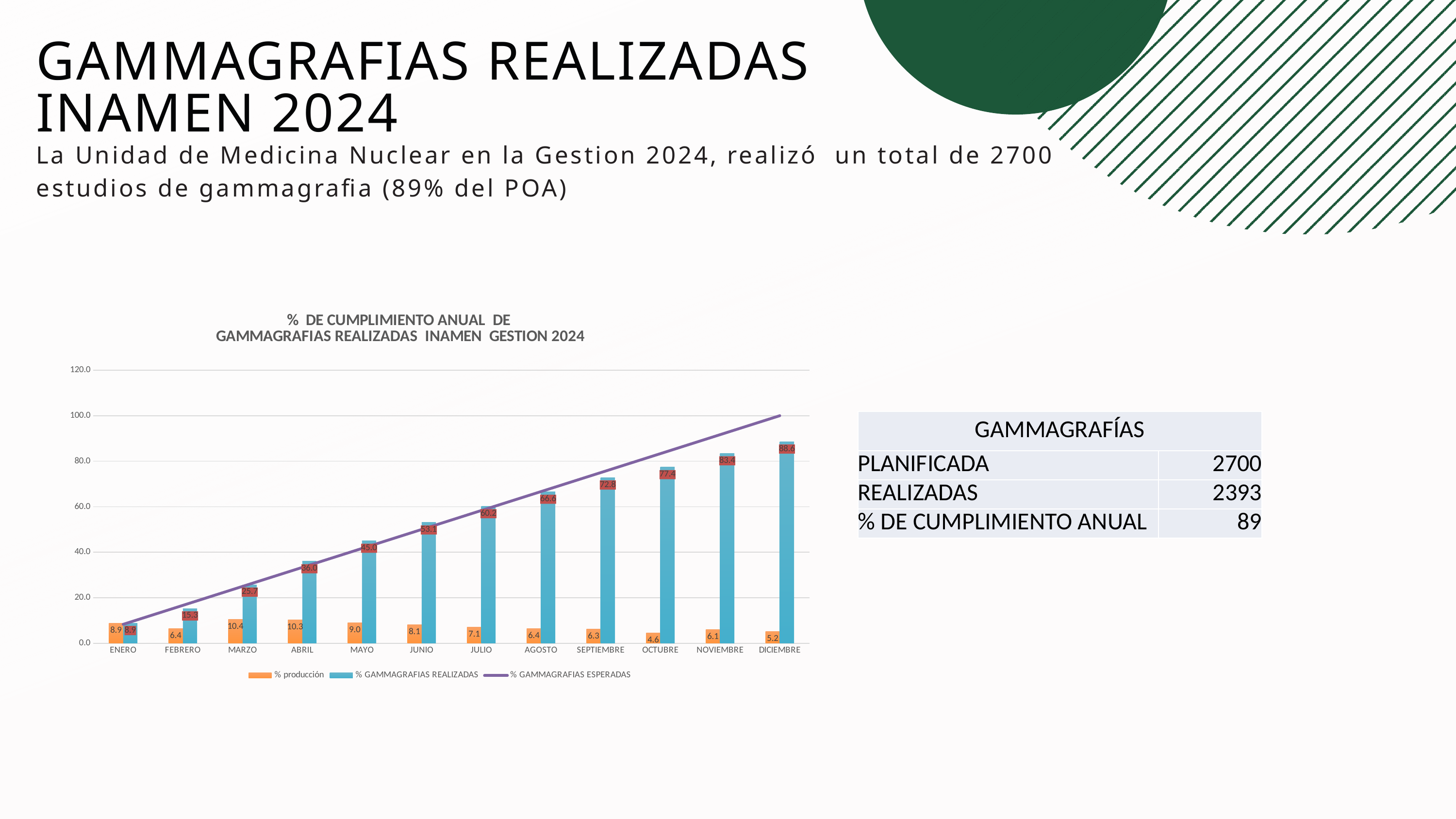
What is the % producción value for MARZO? 10.4 Which month has the lowest % producción value? OCTUBRE How many series does the chart legend list? 3 What colour are the % GAMMAGRAFIAS REALIZADAS bars in the chart? blue Which is larger, the % producción value for ENERO or for FEBRERO? ENERO How many months are shown on the x axis of the chart? 12 What is the % GAMMAGRAFIAS REALIZADAS value for JUNIO? 53.1 What type of chart is shown on the slide? bar chart with a line Which month has the highest % producción value? MARZO Does the % GAMMAGRAFIAS REALIZADAS series rise or fall from ENERO to DICIEMBRE? rise What is the % GAMMAGRAFIAS REALIZADAS value for DICIEMBRE? 88.6 What is the difference between the % GAMMAGRAFIAS REALIZADAS values for NOVIEMBRE and OCTUBRE? 6.0